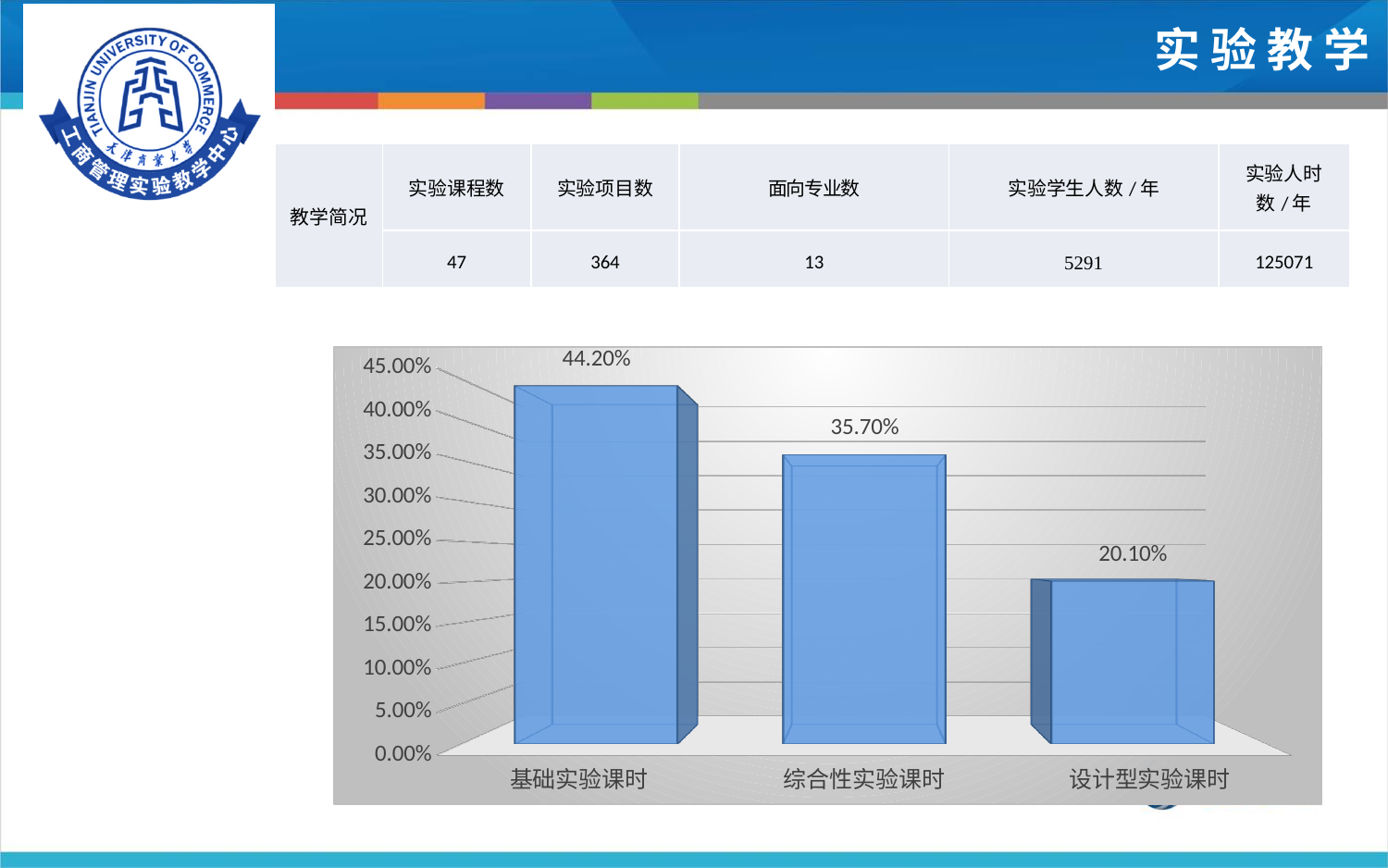
Which category has the highest value? 基础实验课时 Which is larger, the value for 综合性实验课时 or the value for 设计型实验课时? 综合性实验课时 What is the value for 综合性实验课时? 35.70% Do the values rise or fall from left to right along the x axis? fall Is the value for 综合性实验课时 greater or less than 30.00%? greater What is the difference between the values for 综合性实验课时 and 设计型实验课时? 15.60% What is the value for 基础实验课时? 44.20% What kind of chart is shown on the slide? bar chart Which category has the lowest value? 设计型实验课时 How many categories are shown on the x axis? 3 What is the value for 设计型实验课时? 20.10% What is the difference between the values for 基础实验课时 and 综合性实验课时? 8.50%